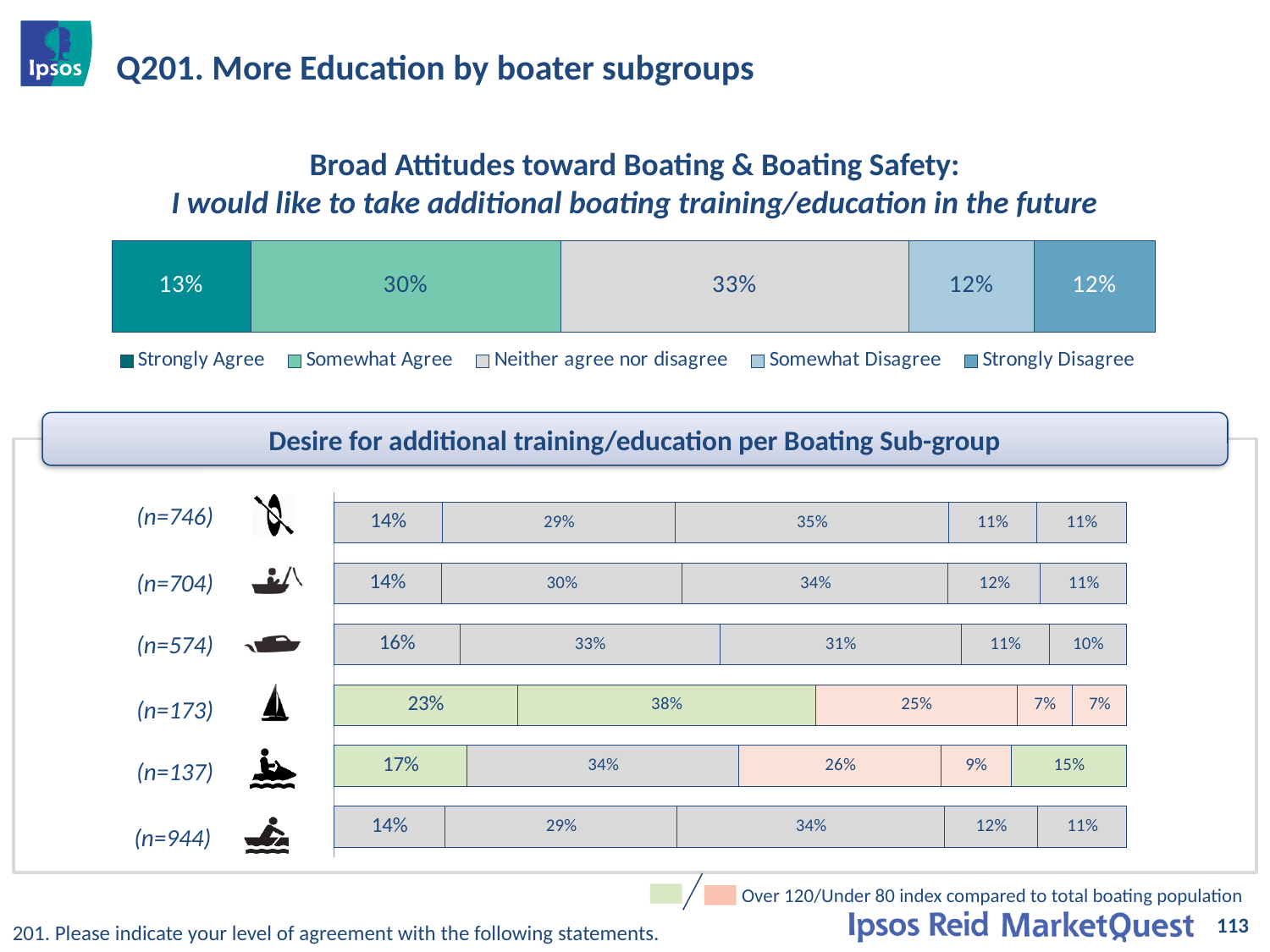
In the bottom chart, what is the rightmost segment value for the (n=137) row? 15% What kind of chart is the top chart? Stacked bar chart In the top chart, which response category has the largest share? Neither agree nor disagree In the bottom chart, what is the difference between the second segment of the (n=173) row (38%) and the second segment of the (n=746) row (29%)? 9 percentage points According to the note below the bottom chart, what do the green and pink shaded segments indicate? Over 120/Under 80 index compared to total boating population How many sub-group rows are plotted in the bottom chart? 6 In the bottom chart (Desire for additional training/education per Boating Sub-group), what is the leftmost segment value for the (n=173) row? 23% In the top chart (Broad Attitudes toward Boating & Boating Safety), what percentage is shown for Strongly Agree? 13% How many series does the legend of the top chart list? 5 In the bottom chart, which row has the larger middle (third) segment: (n=746) or (n=173)? (n=746) In the bottom chart, which row has the highest leftmost segment value? (n=173) In the top chart, what is the total of all segments in the stacked bar? 100%